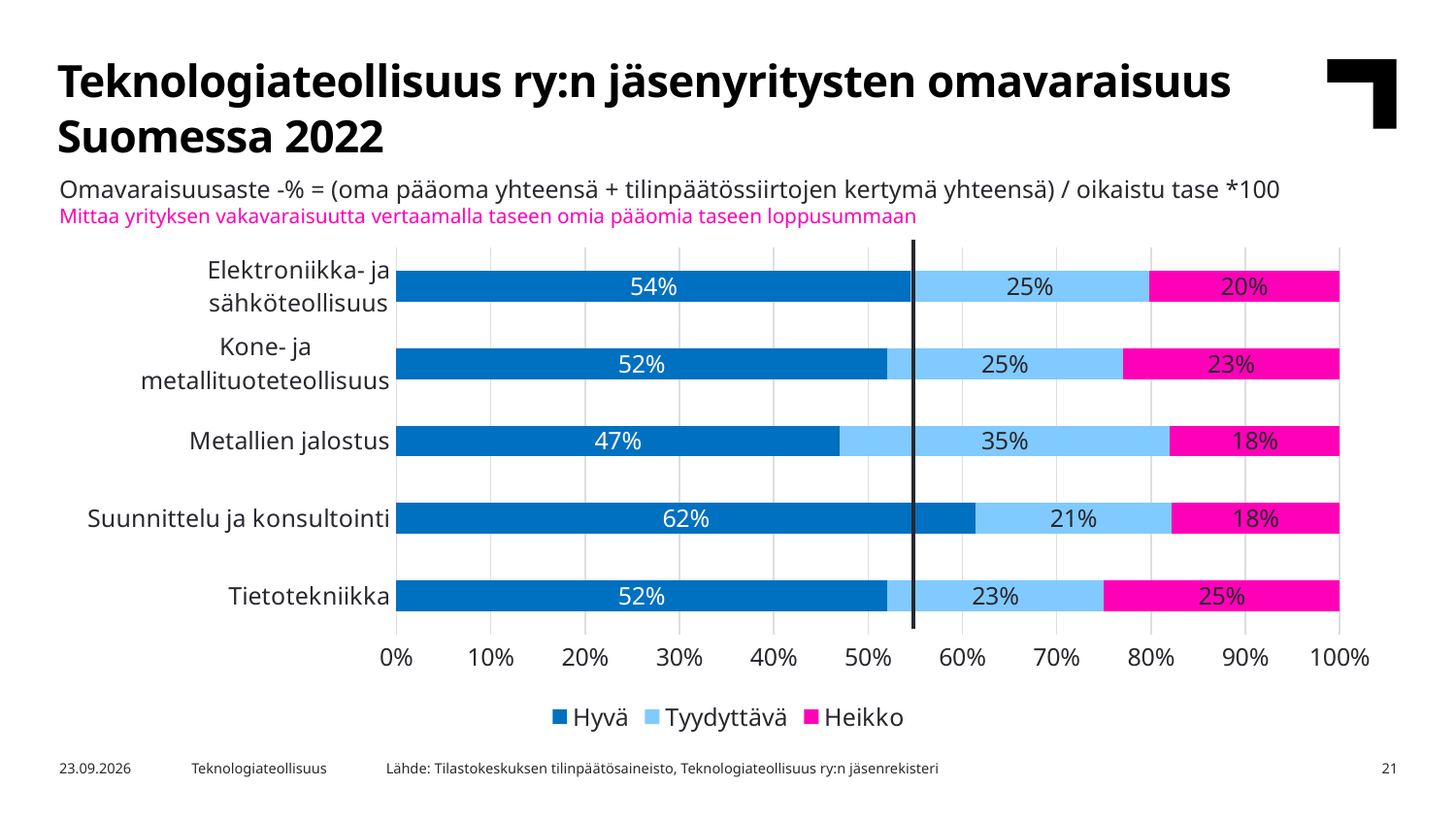
Which is larger: the Heikko value for Tietotekniikka or the Heikko value for Elektroniikka- ja sähköteollisuus? Tietotekniikka What kind of chart is shown on the slide? Stacked bar chart What is the difference between the Hyvä values for Suunnittelu ja konsultointi and Metallien jalostus? 15 percentage points What is the Tyydyttävä value for Metallien jalostus? 35% Which category has the highest Hyvä value? Suunnittelu ja konsultointi What is the Hyvä value for Suunnittelu ja konsultointi? 62% Which series is shown in magenta in the legend? Heikko Which category has the lowest Hyvä value? Metallien jalostus How many categories are shown on the chart? 5 How many series does the legend list? 3 What is the Heikko value for Tietotekniikka? 25% What is the Heikko value for Kone- ja metallituoteteollisuus? 23%